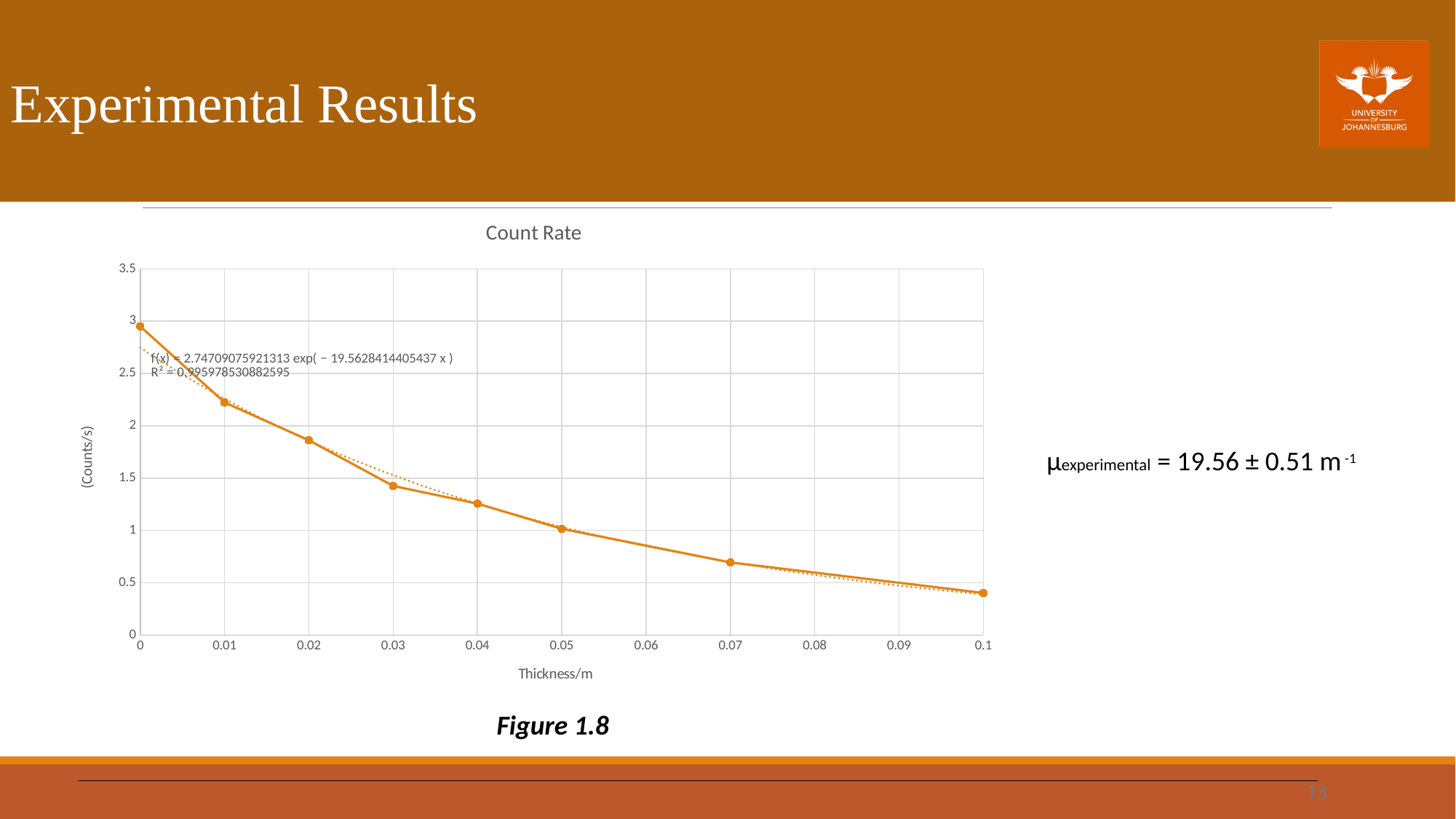
Is the count rate at thickness 0.1 greater or less than 0.5? less Is the count rate at thickness 0.02 greater or less than 1.5? greater Is the count rate at thickness 0 greater or less than 2.5? greater How many data points are plotted on the chart? 8 At which thickness is the count rate lowest? 0.1 What is the label of the x axis of the chart? Thickness/m Do the count rate values rise or fall as thickness increases along the x axis? fall What is the title of the chart? Count Rate What kind of chart is shown on the slide? line chart Which has the larger count rate: thickness 0.02 or thickness 0.07? 0.02 At which thickness is the count rate highest? 0